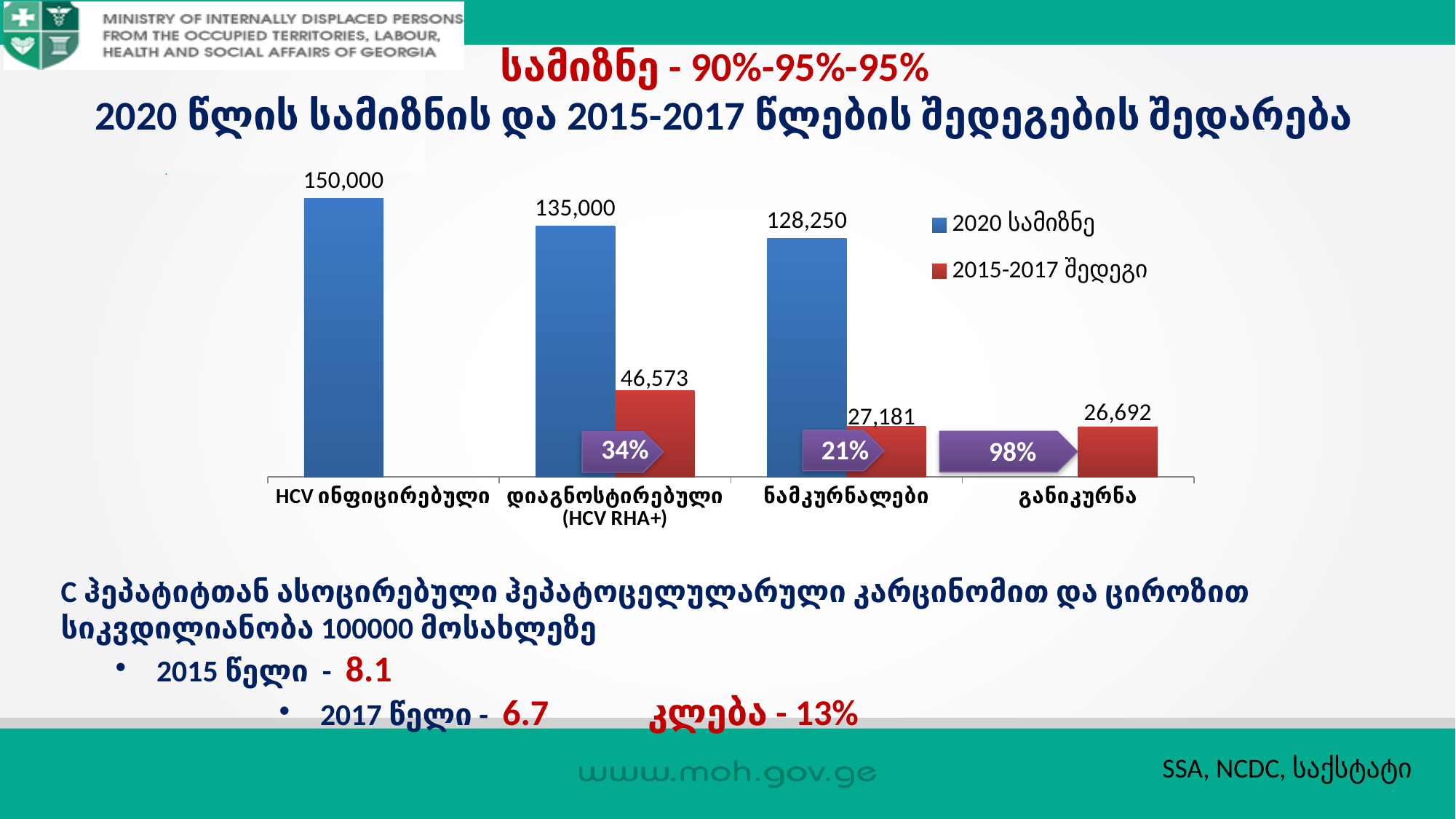
What is the 2020 სამიზნე value for HCV ინფიცირებული? 150,000 Which category has the highest 2020 სამიზნე value? HCV ინფიცირებული Which category has the lowest 2015-2017 შედეგი value? განიკურნა What is the 2015-2017 შედეგი value for განიკურნა? 26,692 How many categories are shown on the x axis of the chart? 4 What is the 2020 სამიზნე value for დიაგნოსტირებული (HCV RHA+)? 135,000 What is the 2015-2017 შედეგი value for ნამკურნალები? 27,181 What percentage is shown in the purple arrow next to the განიკურნა bar? 98% What kind of chart is shown on the slide? Bar chart What is the difference between the 2020 სამიზნე and the 2015-2017 შედეგი for დიაგნოსტირებული (HCV RHA+)? 88,427 Which is larger for ნამკურნალები: the 2020 სამიზნე or the 2015-2017 შედეგი? 2020 სამიზნე How many series does the chart legend list? 2